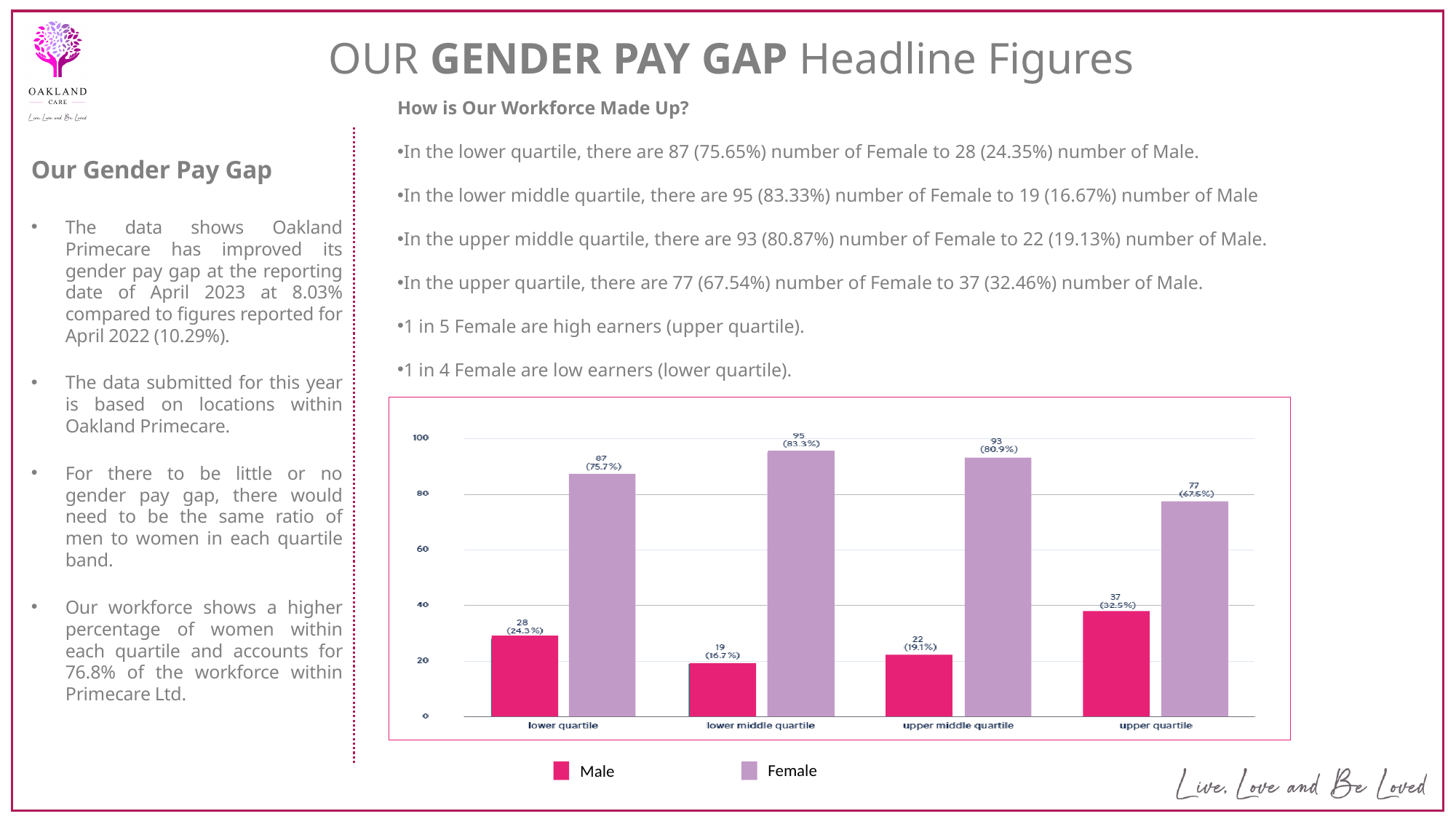
Which is larger in the upper quartile, the Male bar or the Female bar? Female Which colour represents the Female series in the chart? light purple What is the difference between the Female and Male counts in the upper middle quartile? 71 What percentage is shown for Female in the upper quartile on the chart? 67.5% What type of chart is shown on the slide? bar chart How many quartile categories are shown on the x axis of the chart? 4 In which quartile is the Male bar lowest? lower middle quartile Is the value for Male in the upper quartile greater or less than 40? less What is the number of Male employees in the lower quartile according to the chart? 28 What is the number of Female employees in the lower middle quartile according to the chart? 95 How many series does the chart legend list? 2 In which quartile is the Female bar highest? lower middle quartile